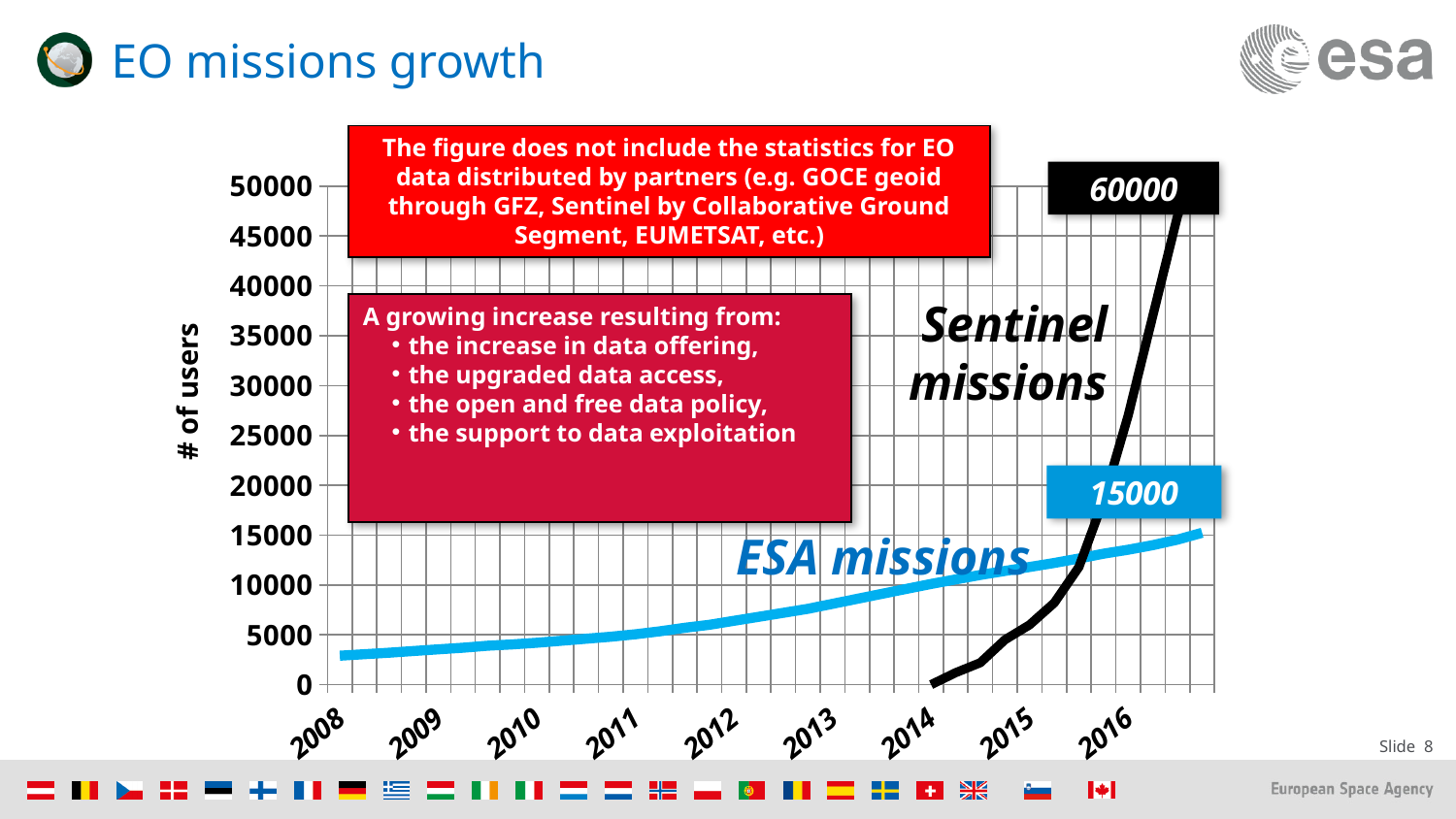
What is the difference between the labelled end values for Sentinel missions (60000) and ESA missions (15000)? 45000 Which series has the higher number of users in 2016, ESA missions or Sentinel missions? Sentinel missions How many lines (series) are plotted on the chart? 2 What value is labelled for Sentinel missions at the end of the chart? 60000 Is the value for ESA missions in 2008 greater or less than 5000? less Is the value for ESA missions in 2012 greater or less than 10000? less What is the label of the y axis of the chart? # of users In which year does the Sentinel missions line start on the chart? 2014 What kind of chart is shown on the slide? line chart What value is labelled for ESA missions at the end of the chart? 15000 Does the number of users for ESA missions rise or fall from 2008 to 2016? rise How many years are labelled on the x axis of the chart? 9